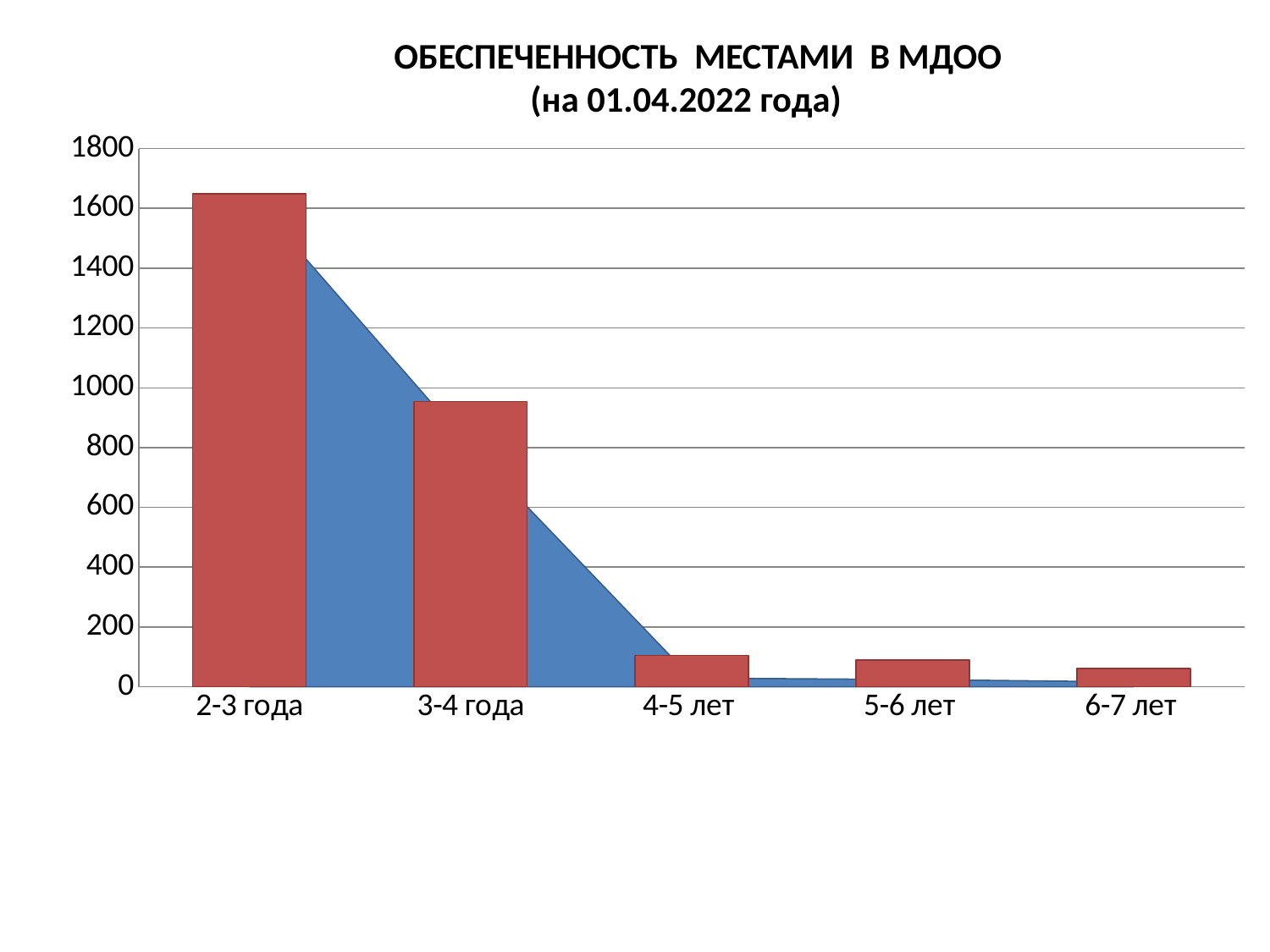
Is the value for 4-5 лет greater or less than 200? less What date is given in the chart title? 01.04.2022 What kind of chart is shown on the slide? combination bar and area chart Which age category has the lowest bar? 6-7 лет Which age category has the highest bar? 2-3 года Is the value for 3-4 года greater or less than 1000? less Is the value for 3-4 года greater or less than 800? greater Which is larger, the bar for 2-3 года or the bar for 3-4 года? 2-3 года Do the bar values rise or fall from 2-3 года to 6-7 лет? fall How many age categories are shown on the x axis? 5 Which is larger, the bar for 4-5 лет or the bar for 6-7 лет? 4-5 лет